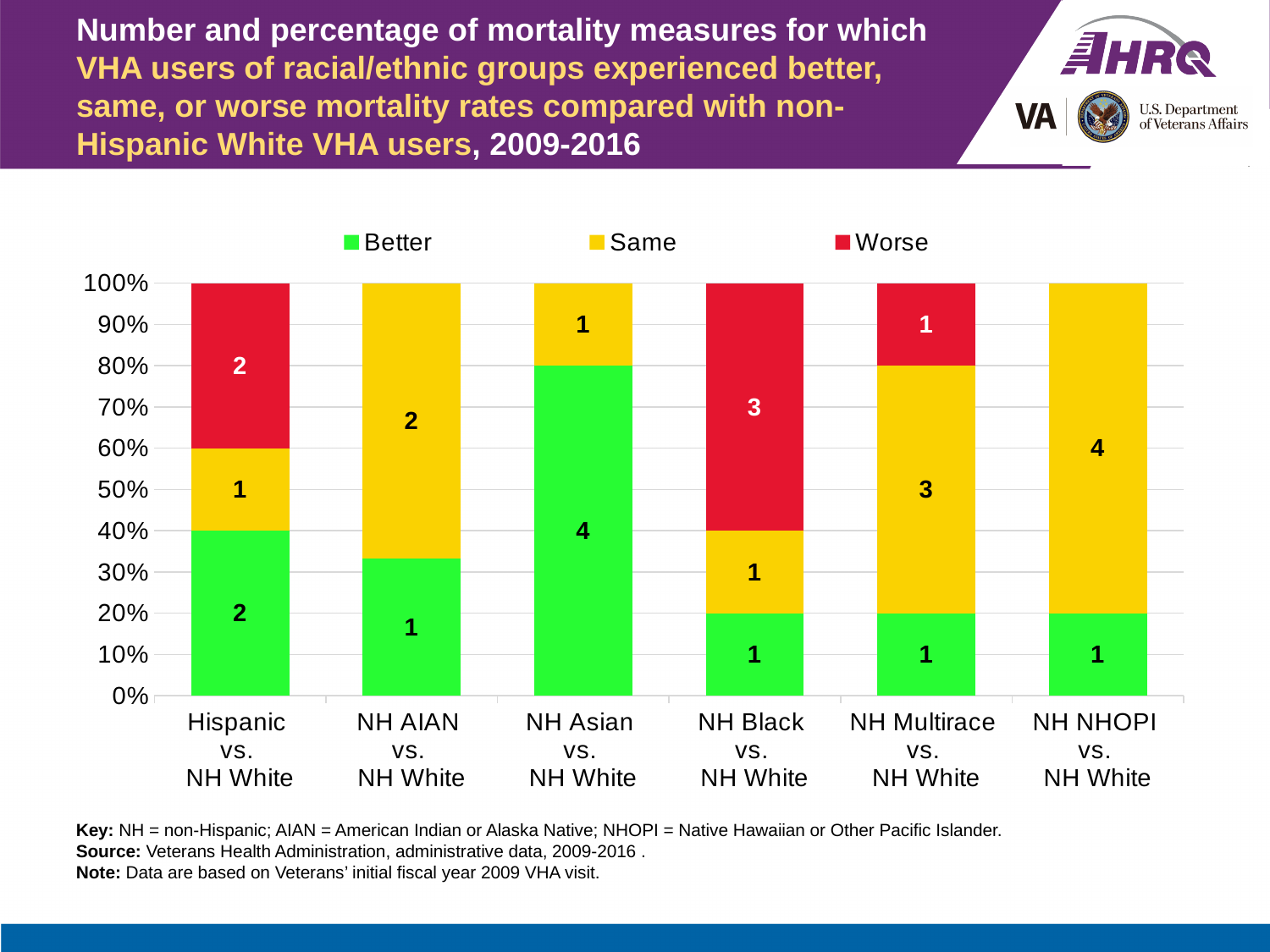
What is the total number of mortality measures for Hispanic vs. NH White? 5 Which colour represents the 'Worse' series in the legend? red How many mortality measures were 'Worse' for NH Black vs. NH White? 3 How many mortality measures were 'Better' for NH Asian vs. NH White? 4 How many racial/ethnic group comparisons are shown along the x axis? 6 How many mortality measures were 'Same' for NH NHOPI vs. NH White? 4 Which group has the highest number of 'Better' mortality measures? NH Asian vs. NH White What is the total number of mortality measures for NH AIAN vs. NH White? 3 Which group has the highest number of 'Worse' mortality measures? NH Black vs. NH White How many series does the legend list? 3 What is the difference between the 'Same' count for NH Multirace vs. NH White and the 'Same' count for NH Black vs. NH White? 2 What kind of chart is shown on the slide? stacked bar chart